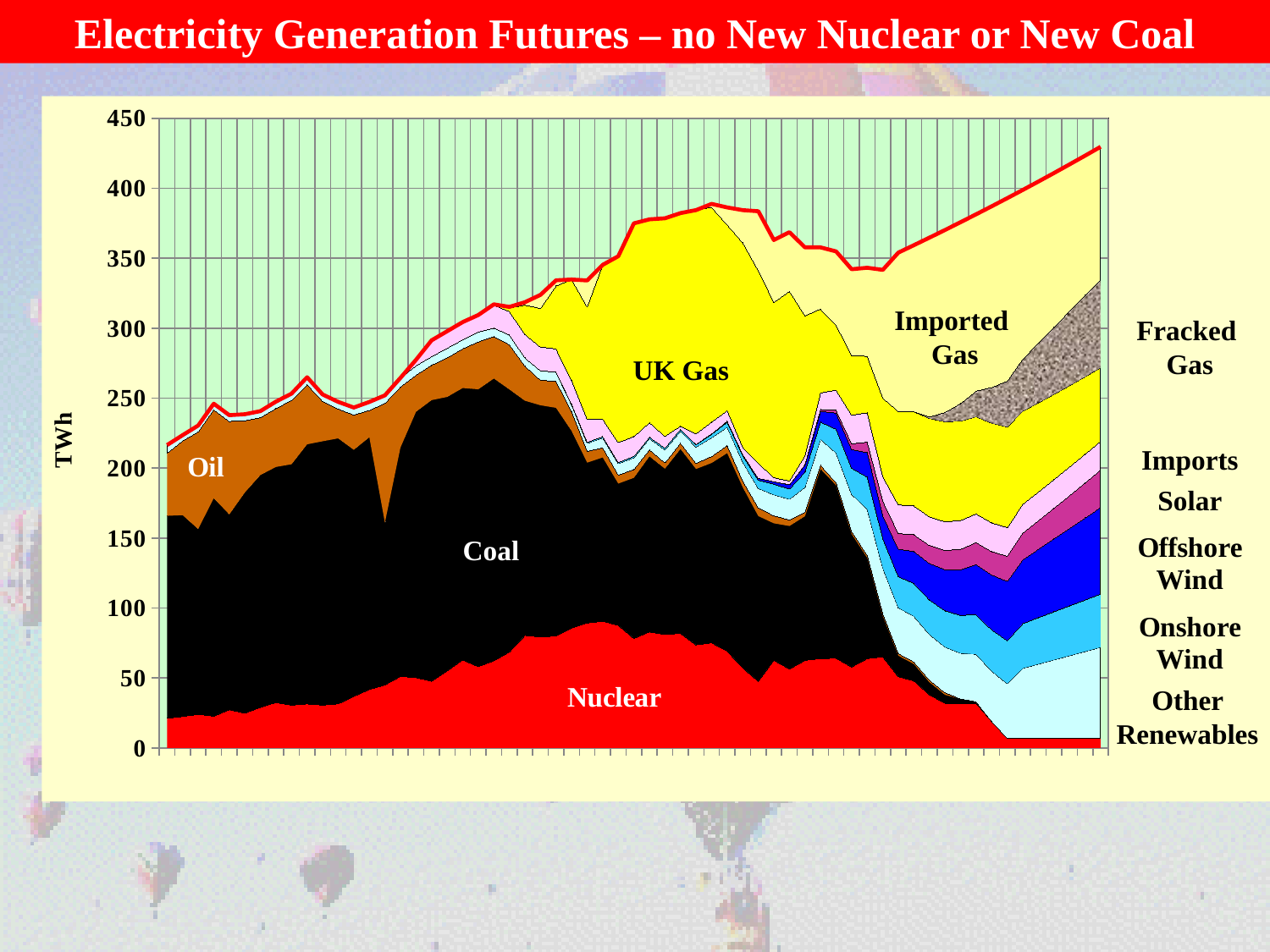
What unit is shown on the vertical axis of the chart? TWh Is the total generation at the right-hand end of the chart greater or less than 400 TWh? greater What kind of chart is shown on the slide? Stacked area chart Is the highest point of the total generation line in the middle of the chart greater or less than 400 TWh? less Which is larger at the right-hand end of the chart: the Fracked Gas band or the Nuclear band? Fracked Gas What is the title of the slide's chart? Electricity Generation Futures – no New Nuclear or New Coal How many generation sources are labelled on the chart? 11 Does the total generation rise or fall between the left-hand end and the right-hand end of the chart? rise Is the Nuclear generation at the right-hand end of the chart greater or less than 50 TWh? less Which generation source is plotted at the bottom of the stack? Nuclear